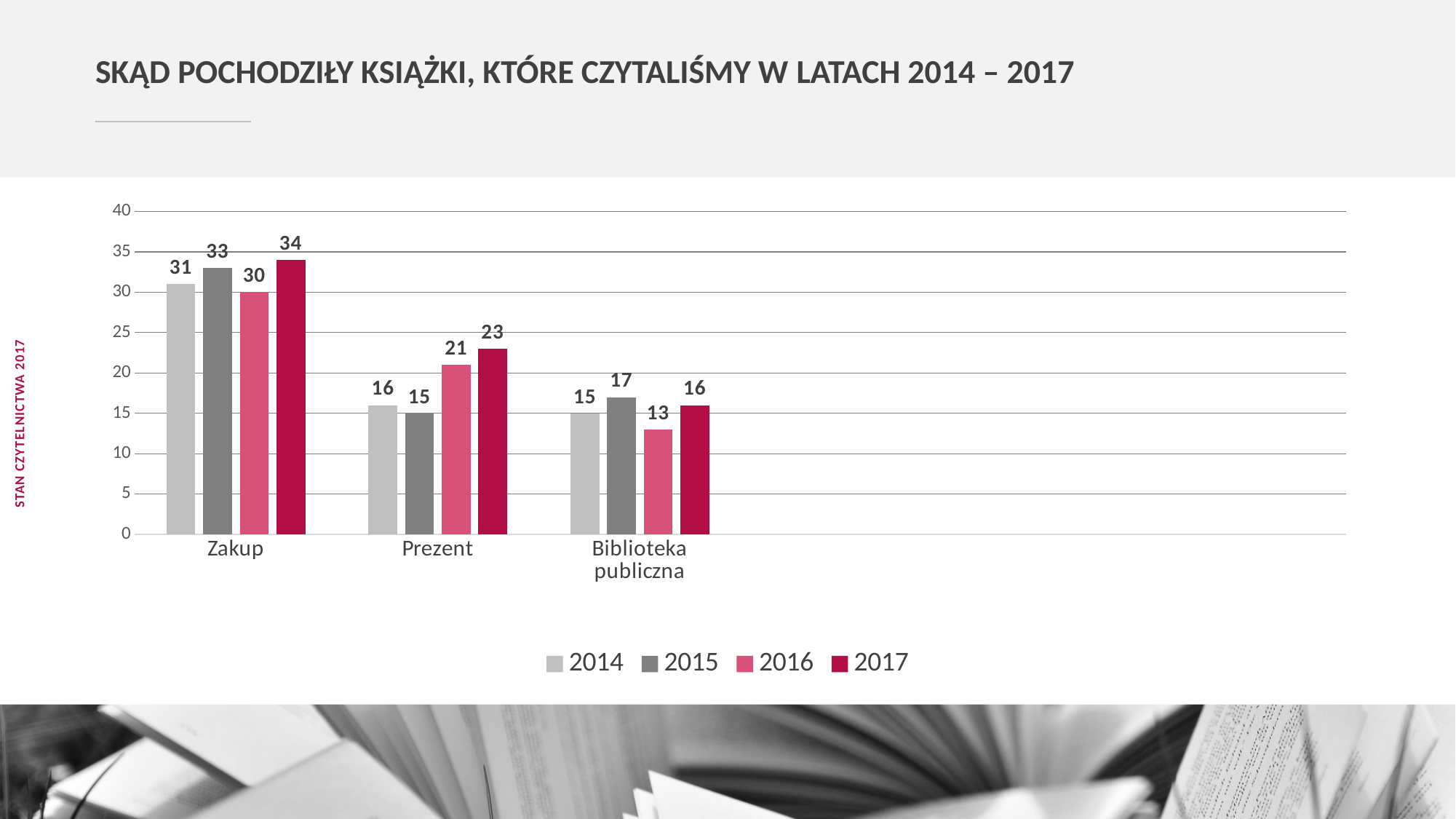
What is the value for Prezent in 2016? 21 How many series does the legend list? 4 Which category has the highest value in 2014? Zakup What is the value for Zakup in 2017? 34 What is the value for Biblioteka publiczna in 2015? 17 Which category has the lowest value in 2016? Biblioteka publiczna Which is larger: the 2015 value for Zakup or the 2016 value for Zakup? 2015 How many categories are shown on the x axis? 3 Which year is shown in the darkest red colour in the legend? 2017 What is the difference between the 2017 and 2014 values for Prezent? 7 Do the values for Prezent rise or fall from 2015 to 2017? Rise What kind of chart is shown on the slide? Bar chart